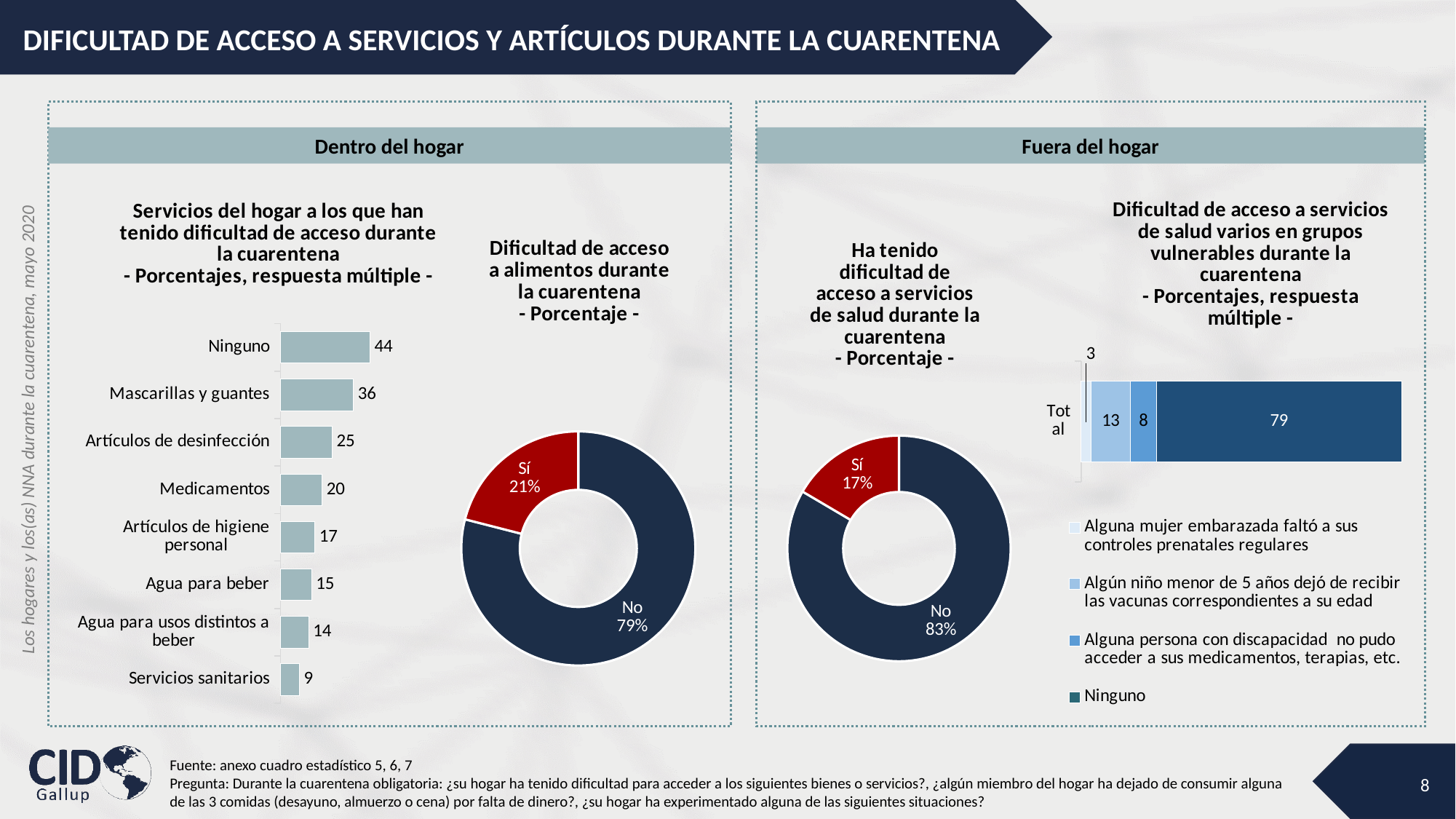
In the bar chart 'Servicios del hogar a los que han tenido dificultad de acceso durante la cuarentena', how many categories are shown? 8 In the bar chart 'Servicios del hogar a los que han tenido dificultad de acceso durante la cuarentena', what is the difference between Artículos de desinfección and Medicamentos? 5 In the bar chart 'Servicios del hogar a los que han tenido dificultad de acceso durante la cuarentena', which category has the lowest value? Servicios sanitarios In the bar chart 'Servicios del hogar a los que han tenido dificultad de acceso durante la cuarentena', which category has the highest value? Ninguno In the stacked bar chart 'Dificultad de acceso a servicios de salud varios en grupos vulnerables durante la cuarentena', what is the value for 'Algún niño menor de 5 años dejó de recibir las vacunas correspondientes a su edad'? 13 In the stacked bar chart 'Dificultad de acceso a servicios de salud varios en grupos vulnerables durante la cuarentena', what is the value for Ninguno? 79 In the chart 'Dificultad de acceso a alimentos durante la cuarentena', what share of the pie is Sí? 21% In the bar chart 'Servicios del hogar a los que han tenido dificultad de acceso durante la cuarentena', what is the value for Mascarillas y guantes? 36 In the bar chart 'Servicios del hogar a los que han tenido dificultad de acceso durante la cuarentena', which is larger: Agua para beber or Agua para usos distintos a beber? Agua para beber In the stacked bar chart 'Dificultad de acceso a servicios de salud varios en grupos vulnerables durante la cuarentena', how many series does the legend list? 4 What kind of chart is 'Dificultad de acceso a alimentos durante la cuarentena'? Donut (pie) chart In the chart 'Ha tenido dificultad de acceso a servicios de salud durante la cuarentena', what is the value for No? 83%